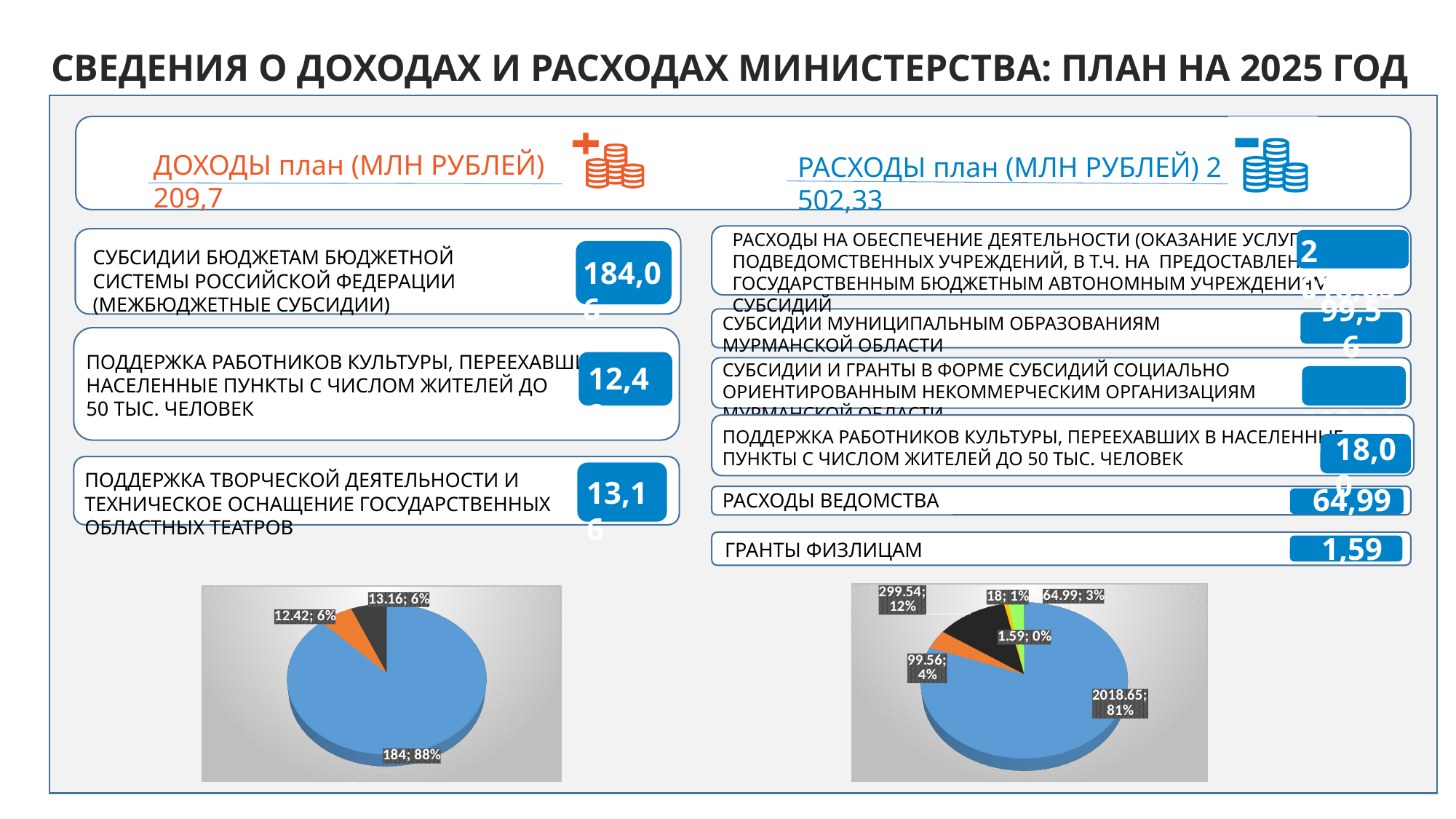
In the pie chart at the bottom left, what share of the pie does the slice with value 184 represent? 88% In the pie chart at the bottom left, what is the data label of the largest slice? 184; 88% In the pie chart at the bottom right, what is the data label of the largest slice? 2018.65; 81% In the pie chart at the bottom right, what is the difference between the slices valued 299.54 and 99.56? 199.98 In the pie chart at the bottom left, what is the difference between the slices valued 13.16 and 12.42? 0.74 How many slices does the pie chart at the bottom left of the slide have? 3 In the pie chart at the bottom right, what share of the pie does the slice with value 299.54 represent? 12% What kind of chart is shown at the bottom left of the slide? pie chart How many slices does the pie chart at the bottom right of the slide have? 6 In the pie chart at the bottom right, which slice is larger: the one valued 64.99 or the one valued 18? 64.99 In the pie chart at the bottom right, what is the value of the smallest slice? 1.59 In the pie chart at the bottom left, what is the value of the smallest slice? 12.42